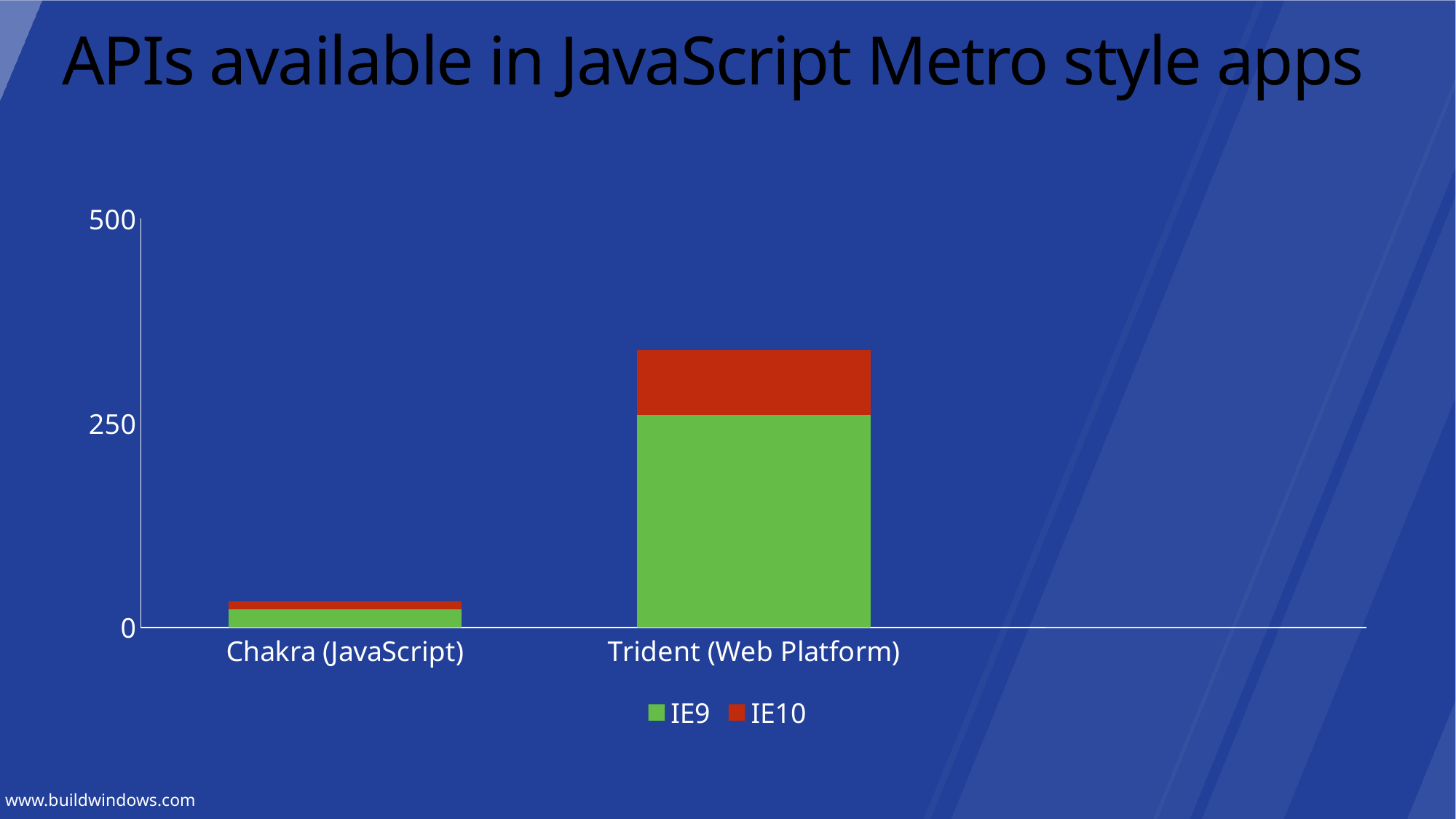
How many series does the legend list? 2 What kind of chart is shown on the slide? Stacked bar chart Which series is shown in green in the legend? IE9 What is the title of the chart? APIs available in JavaScript Metro style apps Which has the larger total bar, Chakra (JavaScript) or Trident (Web Platform)? Trident (Web Platform) Is the total value for Chakra (JavaScript) greater or less than 250? less Which category has the shortest stacked bar? Chakra (JavaScript) Is the total value for Trident (Web Platform) greater or less than 250? greater How many categories are shown on the x axis? 2 Which category has the tallest stacked bar? Trident (Web Platform) Within the Trident (Web Platform) bar, which series takes up the larger portion, IE9 or IE10? IE9 Is the total value for Trident (Web Platform) greater or less than 500? less